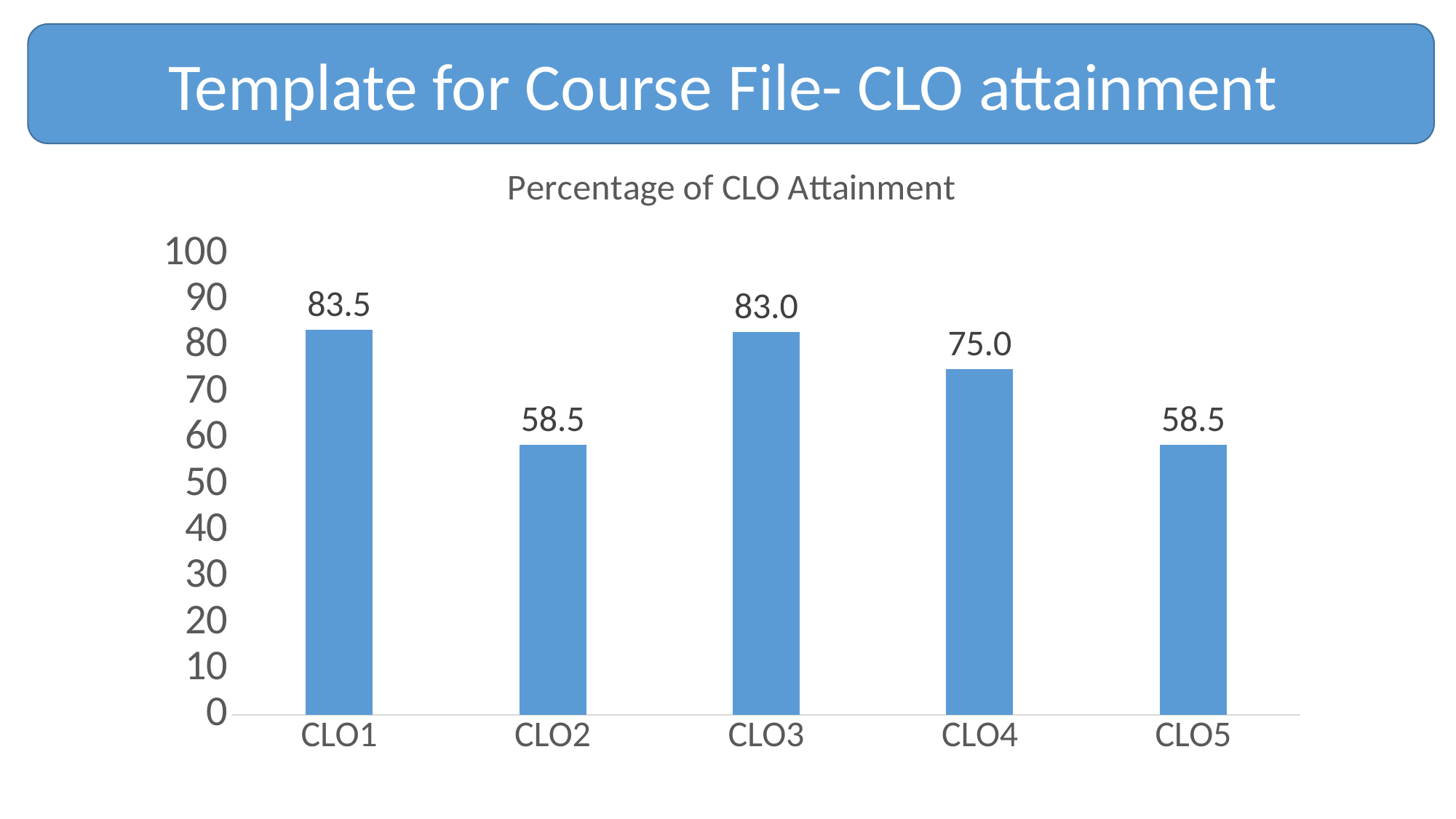
How many categories are shown on the x axis? 5 What is the value for CLO3? 83.0 Which is larger, the value for CLO4 or the value for CLO5? CLO4 What is the title of the chart? Percentage of CLO Attainment Is the value for CLO2 greater or less than 60? less What is the difference between the values for CLO3 and CLO4? 8.0 What is the value for CLO1? 83.5 Which category has the highest value? CLO1 What is the value for CLO4? 75.0 Which two categories share the same value? CLO2 and CLO5 What is the difference between the values for CLO1 and CLO2? 25.0 What kind of chart is shown on the slide? bar chart